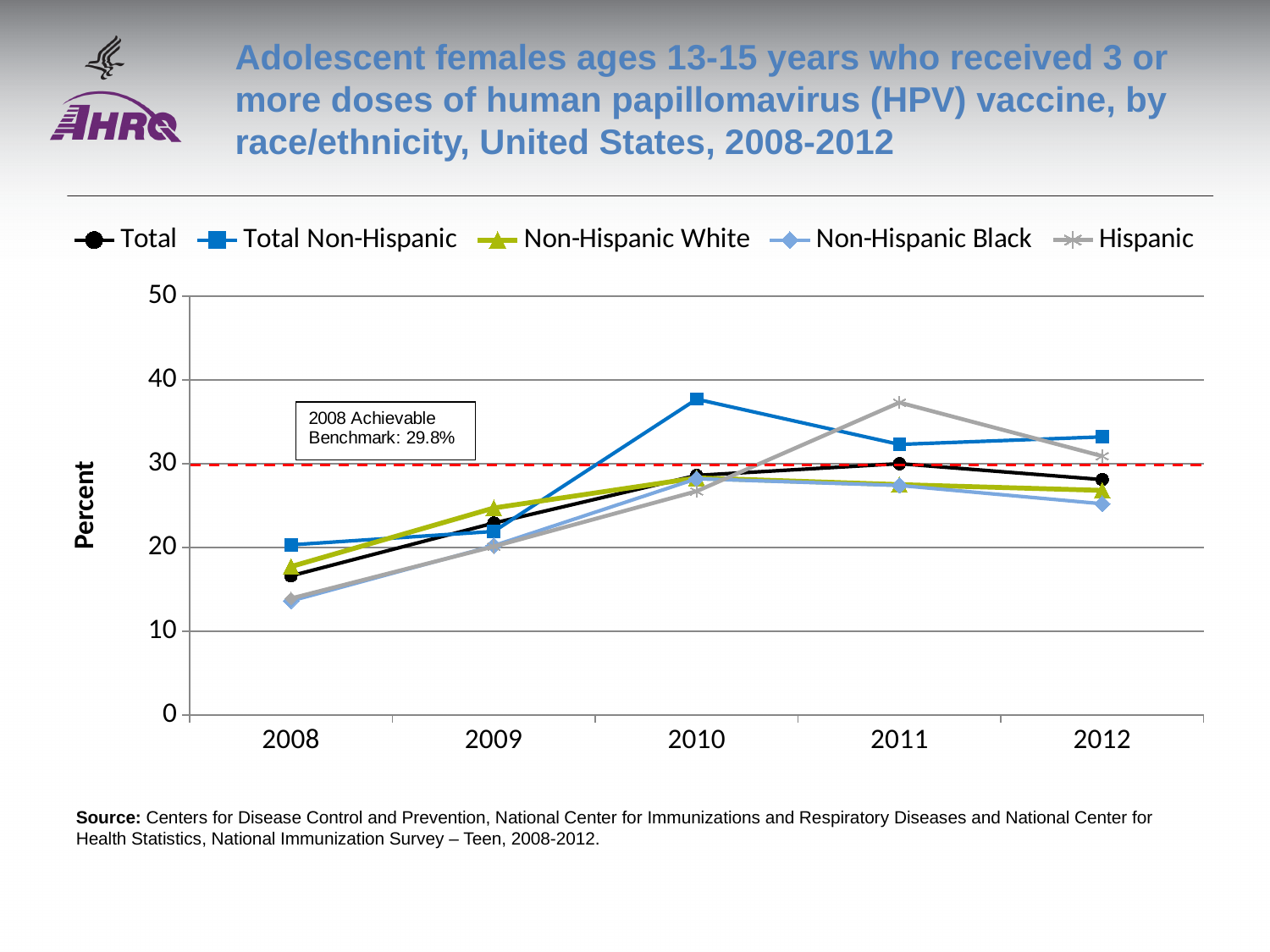
What kind of chart is shown on the slide? line chart Does the Total series rise or fall from 2008 to 2010? rise How many series does the legend list? 5 Which series has the highest value in 2010? Total Non-Hispanic Which series has the highest value in 2011? Hispanic In 2008, which is larger: Total Non-Hispanic or Non-Hispanic Black? Total Non-Hispanic Is the value for Hispanic in 2011 greater or less than 30? greater Is the value for Total Non-Hispanic in 2010 greater or less than 30? greater What is the 2008 Achievable Benchmark value shown on the chart? 29.8% Is the value for Non-Hispanic Black in 2008 greater or less than 20? less What is the label on the y axis? Percent How many years are plotted along the x axis? 5